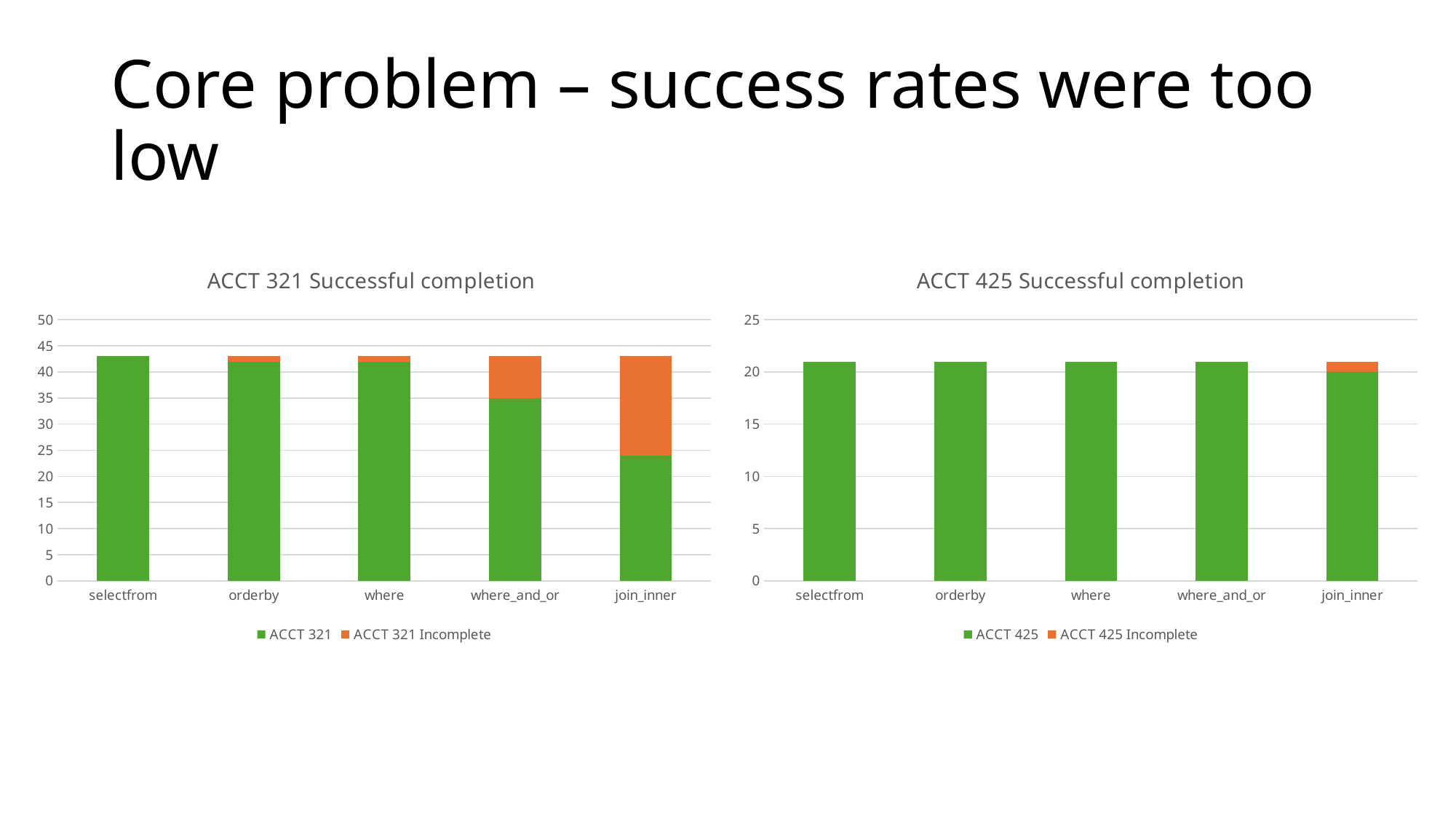
In the ACCT 321 Successful completion chart, is the ACCT 321 value for join_inner greater or less than 30? less How many series does the legend of the ACCT 321 Successful completion chart list? 2 In the ACCT 425 Successful completion chart, which category has an ACCT 425 Incomplete (orange) segment? join_inner In the ACCT 425 Successful completion chart, is the ACCT 425 value for selectfrom greater or less than 15? greater In the ACCT 321 Successful completion chart, which category has the lowest ACCT 321 (green) value? join_inner In the ACCT 321 Successful completion chart, do the ACCT 321 (green) values rise or fall from selectfrom to join_inner? fall What is the title of the chart on the right side of the slide? ACCT 425 Successful completion What kind of chart is the ACCT 321 Successful completion chart? bar chart In the ACCT 321 Successful completion chart, is the ACCT 321 value for selectfrom greater or less than 40? greater In the ACCT 321 Successful completion chart, which category has the largest ACCT 321 Incomplete (orange) segment? join_inner How many categories are shown on the x axis of the ACCT 425 Successful completion chart? 5 In the ACCT 321 Successful completion chart, which is larger, the ACCT 321 value for where or for where_and_or? where